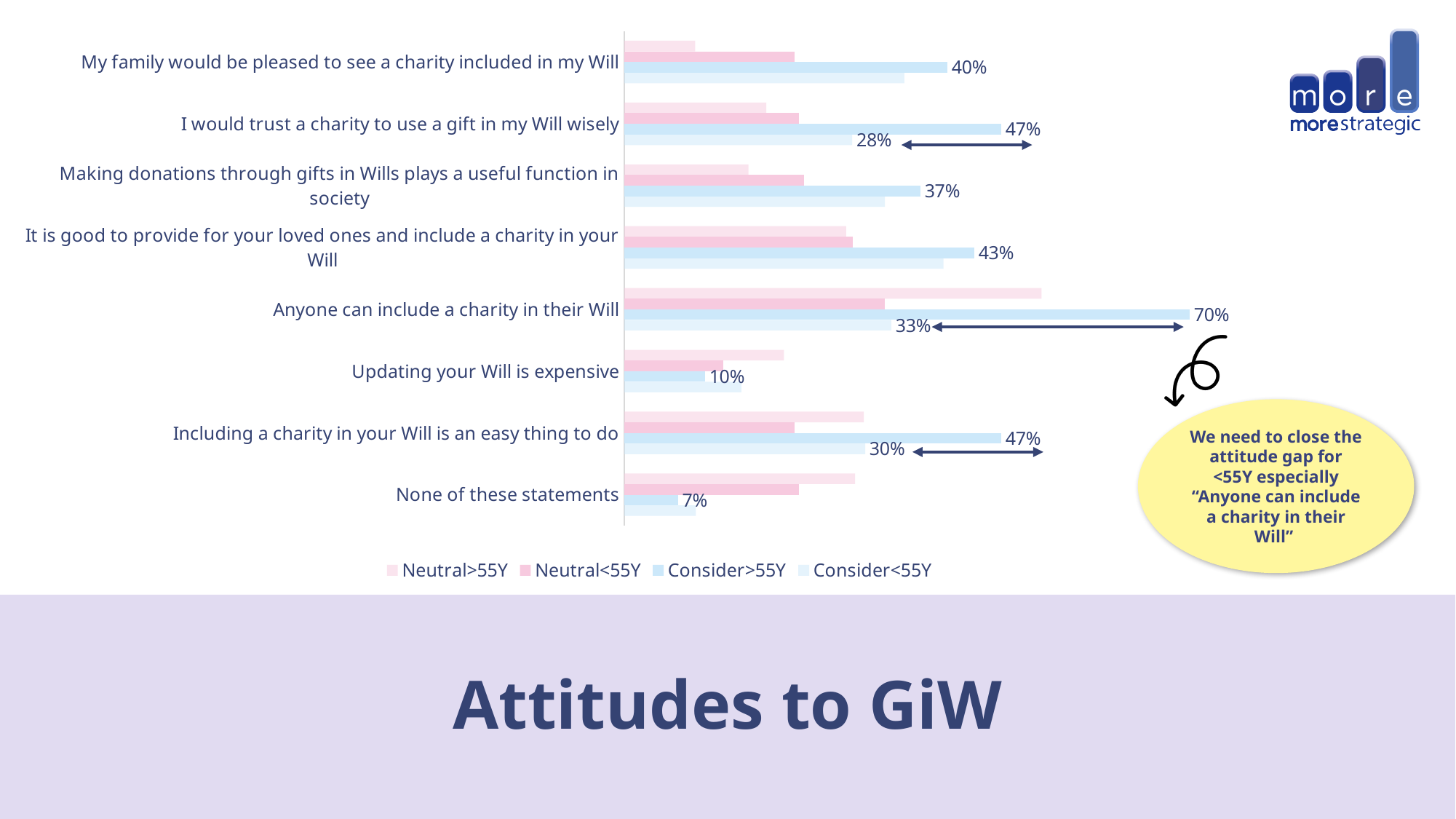
What kind of chart is shown on the slide? Bar chart What is the Consider<55Y value for "Including a charity in your Will is an easy thing to do"? 30% How many series does the legend list? 4 How many statements (categories) are plotted on the chart? 8 Which statement has the highest Consider>55Y value? Anyone can include a charity in their Will What is the title shown on the slide for this chart? Attitudes to GiW What is the difference between the Consider>55Y and Consider<55Y values for "Anyone can include a charity in their Will"? 37 percentage points What is the Consider>55Y value for "Updating your Will is expensive"? 10% What is the Consider<55Y value for "I would trust a charity to use a gift in my Will wisely"? 28% Which is larger: the Consider>55Y value for "It is good to provide for your loved ones and include a charity in your Will" or for "Making donations through gifts in Wills plays a useful function in society"? It is good to provide for your loved ones and include a charity in your Will What is the Consider>55Y value for "Anyone can include a charity in their Will"? 70% Which statement has the lowest Consider>55Y value? None of these statements